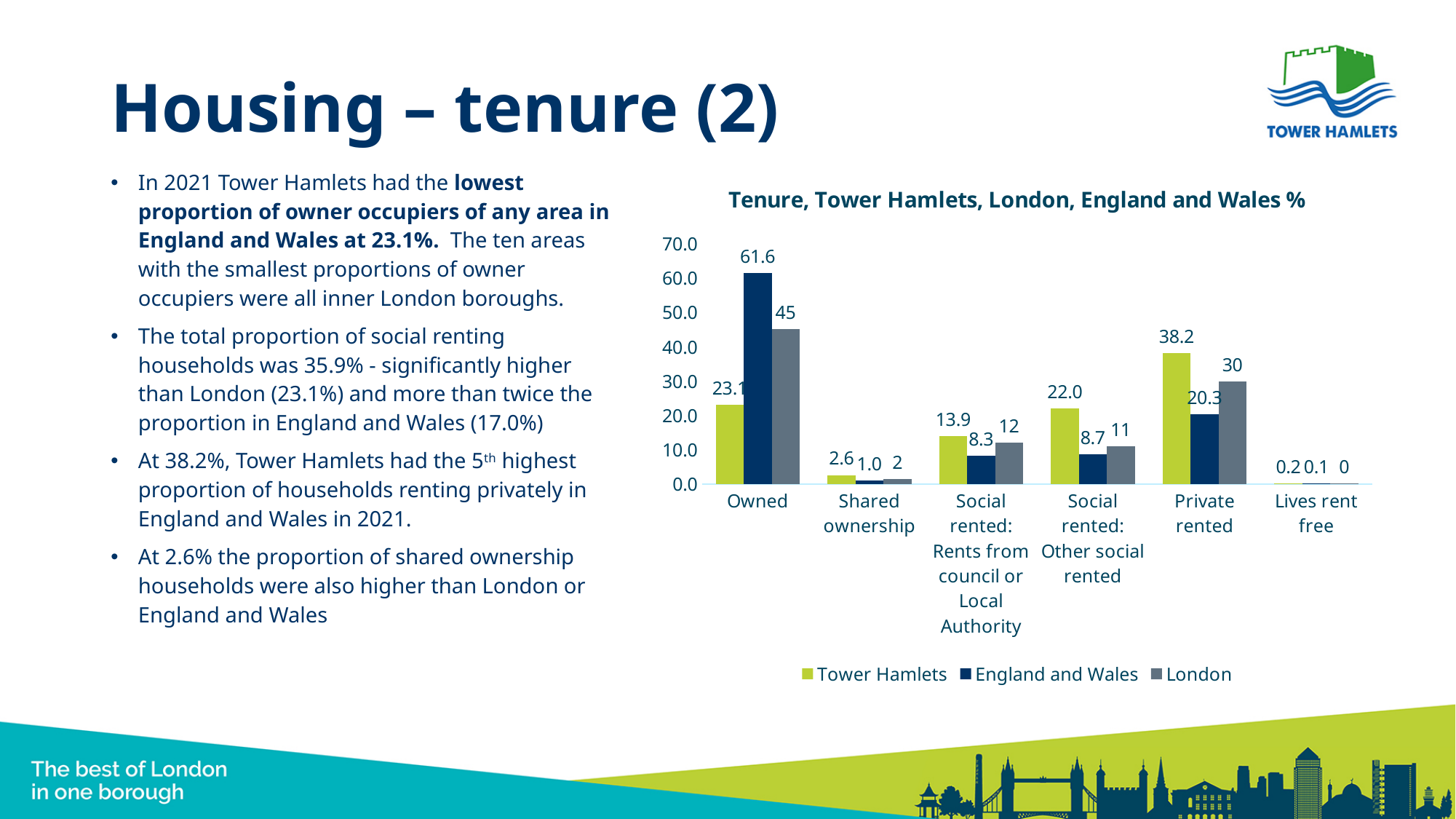
Which is larger for Social rented: Rents from council or Local Authority, the Tower Hamlets value or the London value? Tower Hamlets Which tenure category has the highest Tower Hamlets value? Private rented What is the London value for Social rented: Other social rented? 11 Which tenure category has the lowest England and Wales value? Lives rent free How many series does the legend list? 3 What is the title of the chart? Tenure, Tower Hamlets, London, England and Wales % What is the Tower Hamlets value for Private rented? 38.2 What is the England and Wales value for Owned? 61.6 What kind of chart is shown on the slide? Bar chart How many tenure categories are shown on the x axis? 6 What is the Tower Hamlets value for Shared ownership? 2.6 What is the difference between the England and Wales value and the Tower Hamlets value for Owned? 38.5